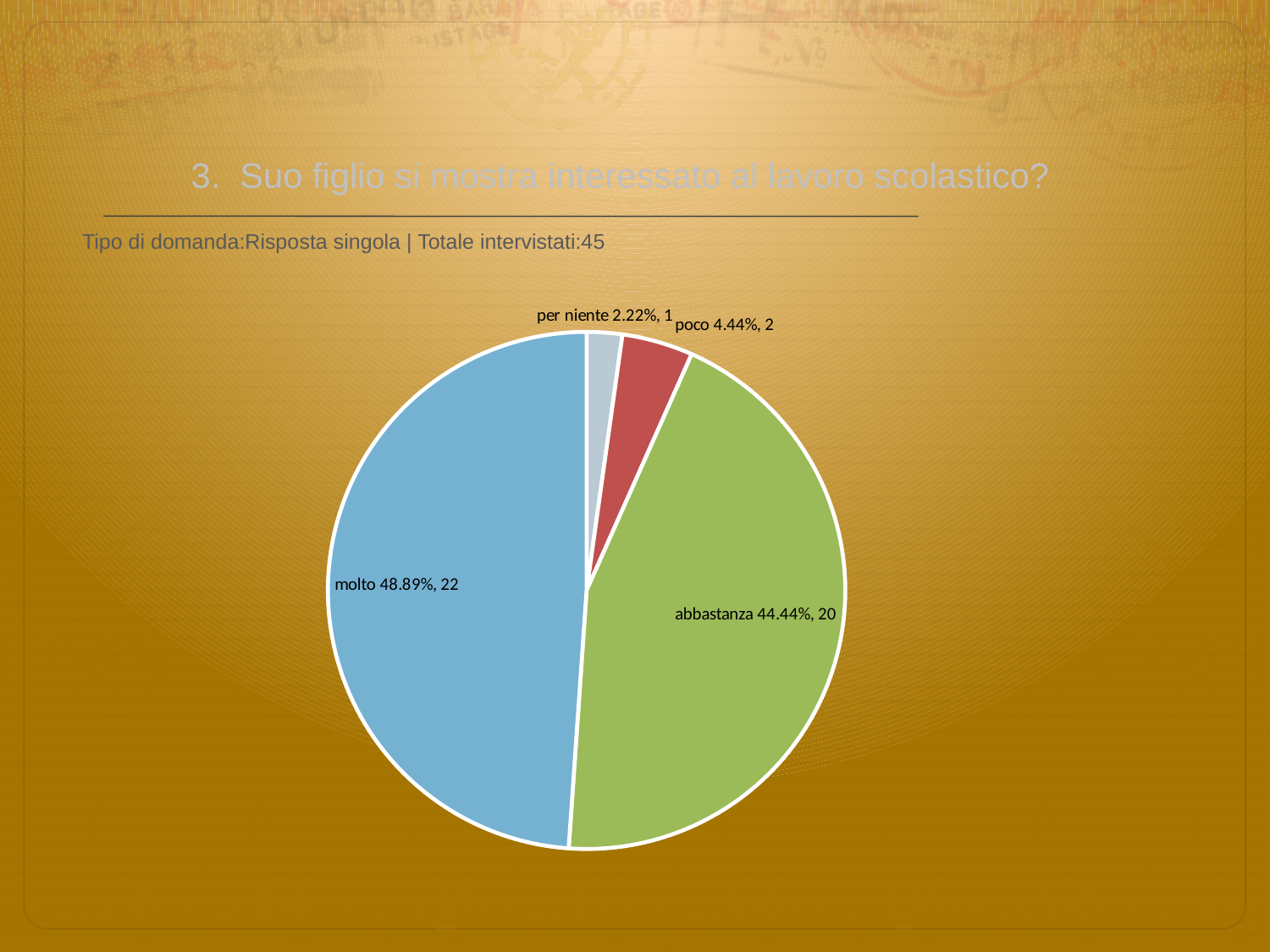
What colour is the 'abbastanza' slice? green Which category has the largest slice? molto What is the difference in respondent count between 'molto' and 'abbastanza'? 2 Which category has the smallest slice? per niente How many respondents answered 'poco'? 2 What percentage share does the 'abbastanza' slice have? 44.44% Which has more respondents, 'poco' or 'per niente'? poco What percentage share does the 'molto' slice have? 48.89% How many slices does the pie chart have? 4 How many respondents answered 'per niente'? 1 What is the total number of respondents across all slices? 45 What kind of chart is shown on the slide? pie chart